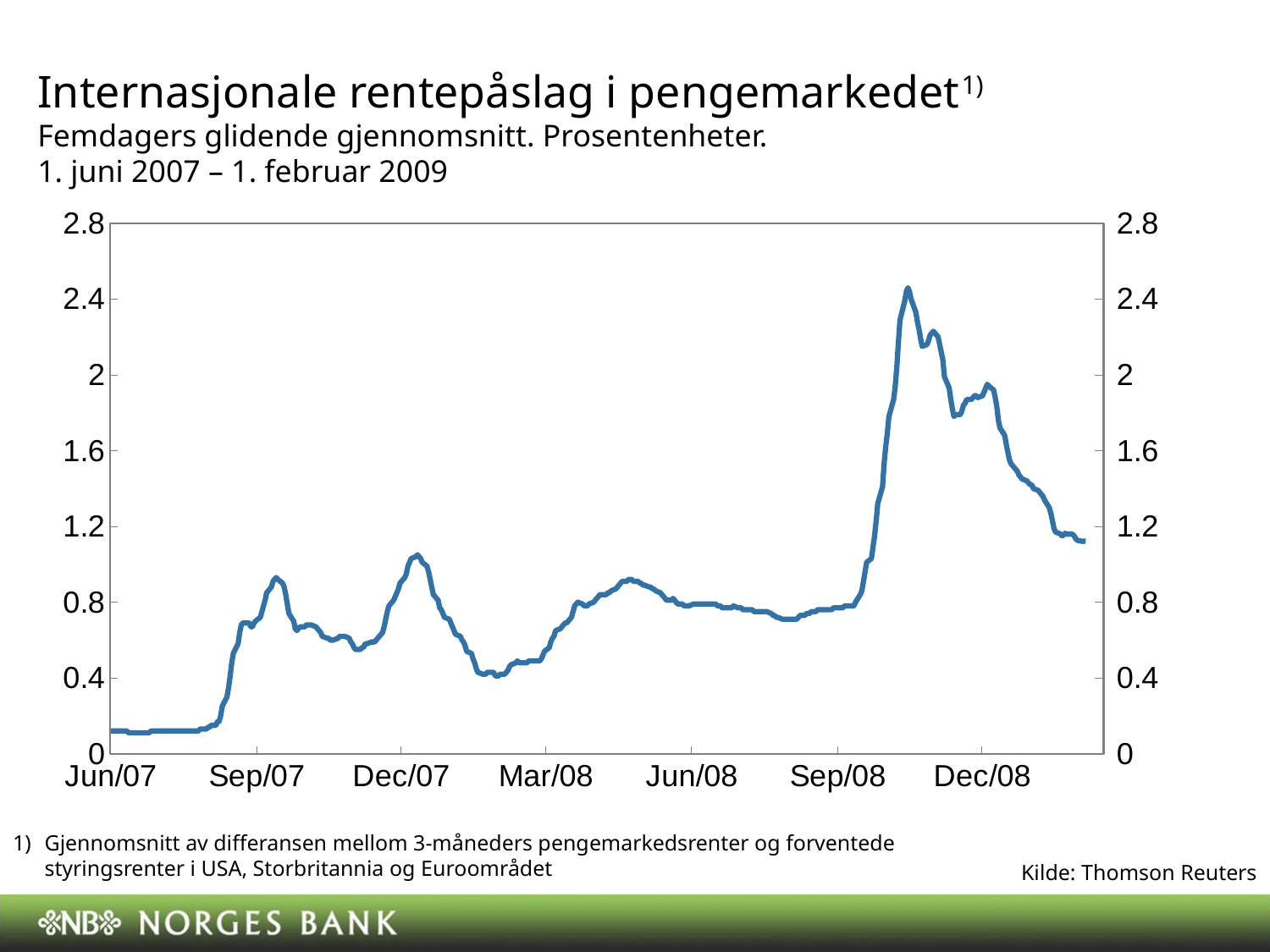
Is the value at Jun/07 greater or less than 0.4? less Is the peak value reached between Sep/08 and Dec/08 greater or less than 2? greater What source is given for the chart? Thomson Reuters Which is larger, the value at Dec/07 or the value at Dec/08? Dec/08 What kind of chart is shown on the slide? line chart Is the value at Mar/08 greater or less than 0.8? less At which labelled x-axis point is the series at its lowest? Jun/07 Does the series rise or fall from its peak after Sep/08 to the end of the period? fall What is the title of the chart? Internasjonale rentepåslag i pengemarkedet